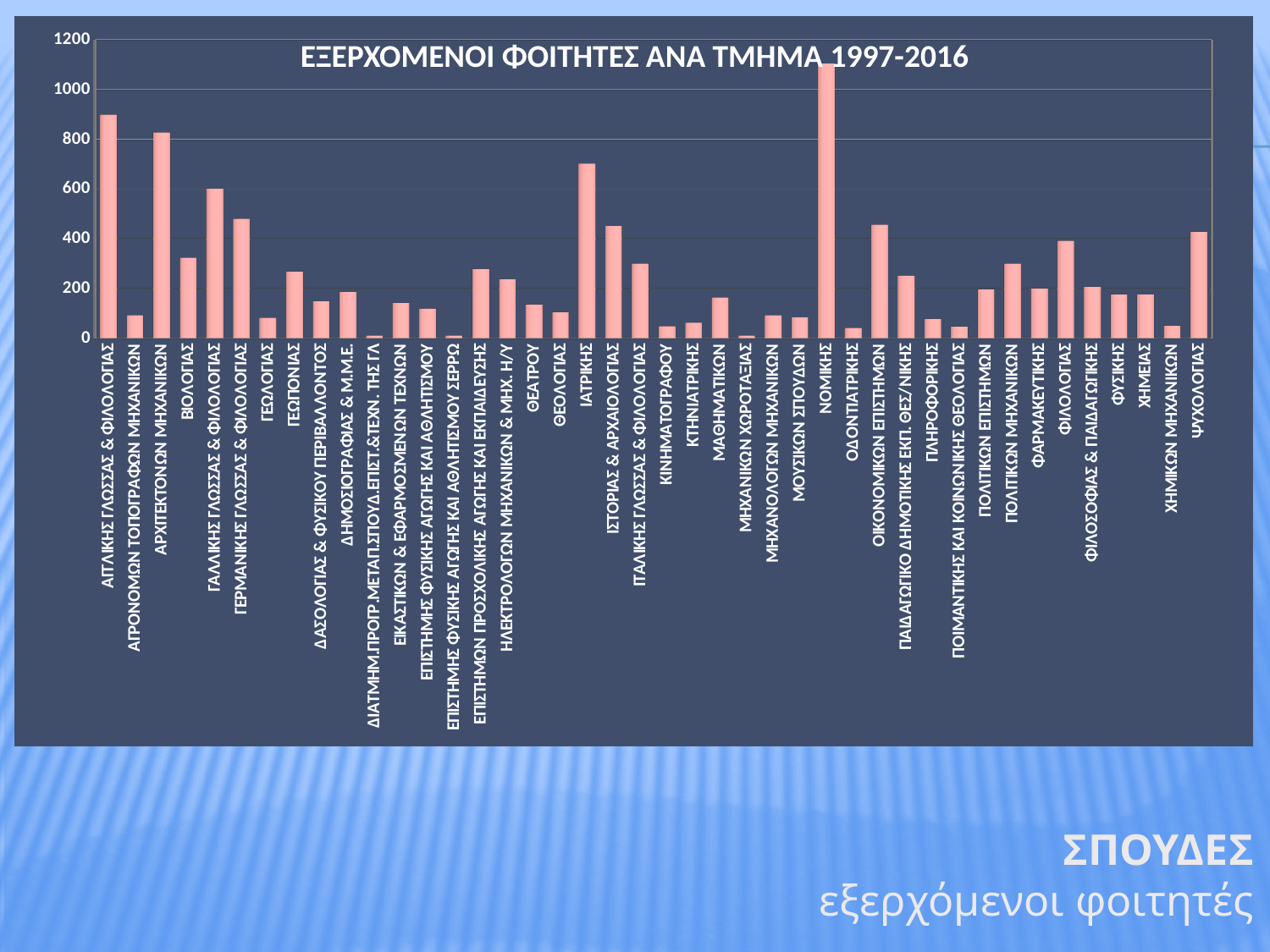
What is the title of the chart? ΕΞΕΡΧΟΜΕΝΟΙ ΦΟΙΤΗΤΕΣ ΑΝΑ ΤΜΗΜΑ 1997-2016 Is the value for ΑΓΓΛΙΚΗΣ ΓΛΩΣΣΑΣ & ΦΙΛΟΛΟΓΙΑΣ greater or less than 800? greater Is the value for ΒΙΟΛΟΓΙΑΣ greater or less than 200? greater Which department has the highest bar in the chart? ΝΟΜΙΚΗΣ Which is larger, the value for ΑΓΓΛΙΚΗΣ ΓΛΩΣΣΑΣ & ΦΙΛΟΛΟΓΙΑΣ or for ΑΡΧΙΤΕΚΤΟΝΩΝ ΜΗΧΑΝΙΚΩΝ? ΑΓΓΛΙΚΗΣ ΓΛΩΣΣΑΣ & ΦΙΛΟΛΟΓΙΑΣ Is the value for ΙΑΤΡΙΚΗΣ greater or less than 600? greater Which is larger, the value for ΓΑΛΛΙΚΗΣ ΓΛΩΣΣΑΣ & ΦΙΛΟΛΟΓΙΑΣ or for ΓΕΡΜΑΝΙΚΗΣ ΓΛΩΣΣΑΣ & ΦΙΛΟΛΟΓΙΑΣ? ΓΑΛΛΙΚΗΣ ΓΛΩΣΣΑΣ & ΦΙΛΟΛΟΓΙΑΣ What kind of chart is shown on the slide? Bar chart Which is larger, the value for ΙΑΤΡΙΚΗΣ or for ΙΣΤΟΡΙΑΣ & ΑΡΧΑΙΟΛΟΓΙΑΣ? ΙΑΤΡΙΚΗΣ